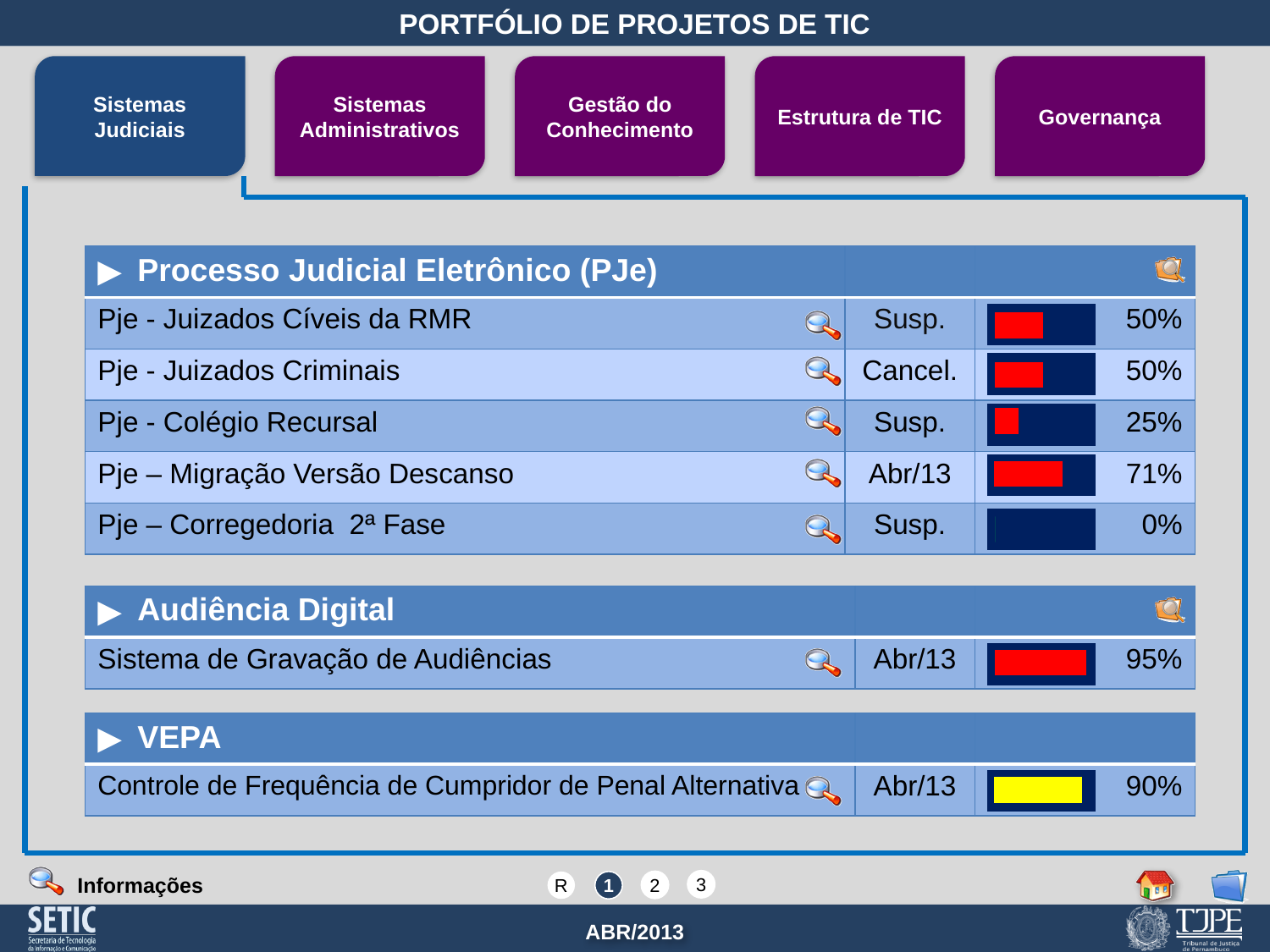
In the VEPA section, what is the completion percentage shown for Controle de Frequência de Cumpridor de Penal Alternativa? 90% In the Processo Judicial Eletrônico (PJe) section, which project has the lowest completion percentage? Pje – Corregedoria 2ª Fase In the Processo Judicial Eletrônico (PJe) section, which project has the highest completion percentage? Pje – Migração Versão Descanso What colour is the progress bar fill for Controle de Frequência de Cumpridor de Penal Alternativa in the VEPA section? Yellow Which has a higher completion percentage: Sistema de Gravação de Audiências or Controle de Frequência de Cumpridor de Penal Alternativa? Sistema de Gravação de Audiências What is the difference in completion percentage between Pje – Migração Versão Descanso and Pje - Colégio Recursal? 46% In the Audiência Digital section, what is the completion percentage shown for Sistema de Gravação de Audiências? 95% In the Processo Judicial Eletrônico (PJe) section, what is the completion percentage shown for Pje - Juizados Cíveis da RMR? 50% In the Processo Judicial Eletrônico (PJe) section, what is the completion percentage shown for Pje – Migração Versão Descanso? 71% How many projects are listed with progress bars in the Processo Judicial Eletrônico (PJe) section? 5 In the Processo Judicial Eletrônico (PJe) section, what is the completion percentage shown for Pje - Colégio Recursal? 25% What is the status shown for Pje - Juizados Criminais? Cancel.